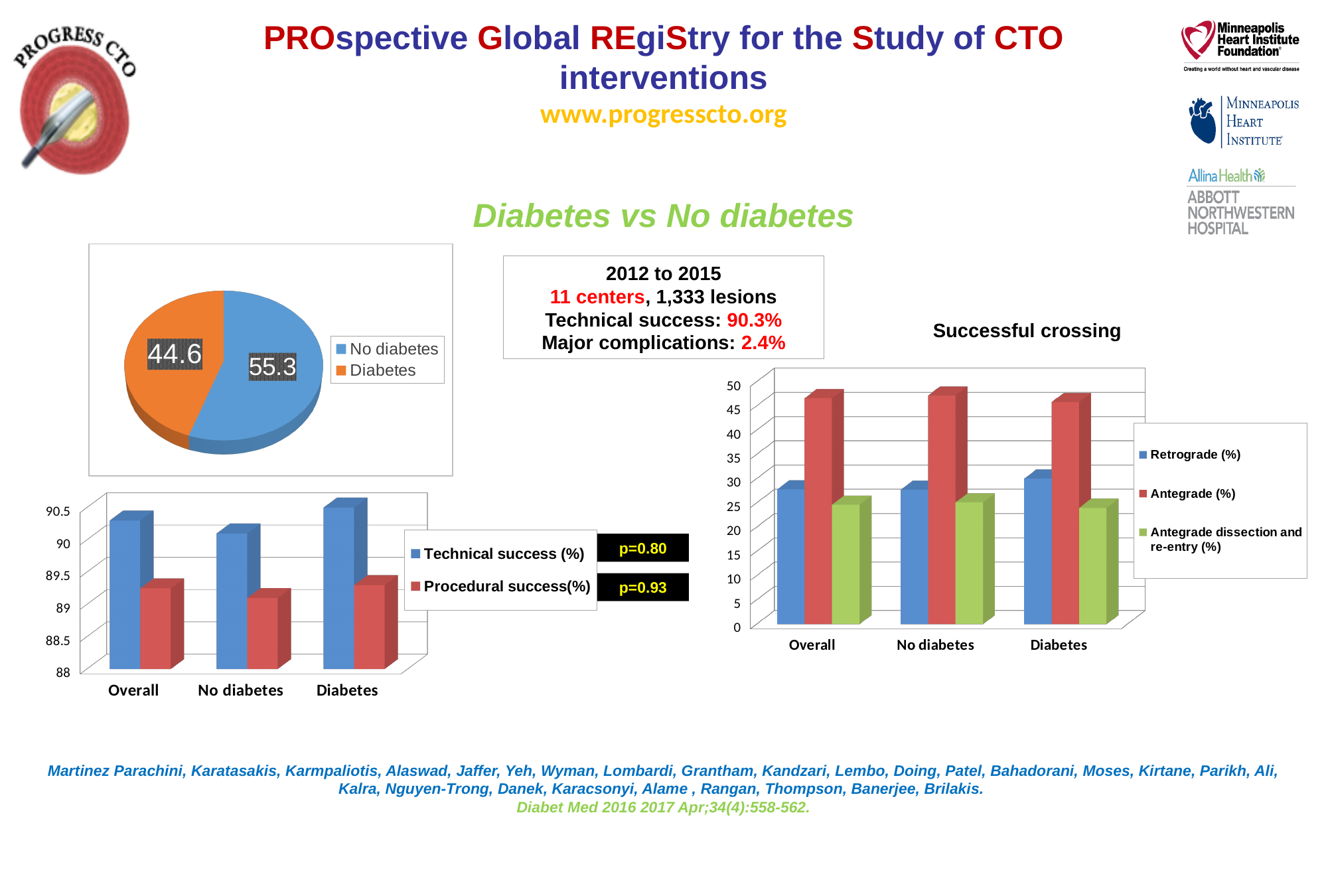
In the Successful crossing chart, is the Antegrade (%) value for Overall greater or less than 40? greater In the bottom-left bar chart, how many categories are shown on the x axis? 3 In the pie chart, what is the value for No diabetes? 55.3 In the pie chart, what is the value for Diabetes? 44.6 In the pie chart, which slice is larger, No diabetes or Diabetes? No diabetes In the Successful crossing chart, how many series does the legend list? 3 What kind of chart is the chart at the top left of the slide? Pie chart In the bottom-left bar chart, is the Technical success (%) value for Diabetes greater or less than 90? greater In the pie chart, what is the difference between the No diabetes and Diabetes values? 10.7 In the bottom-left bar chart, is the Procedural success(%) value for No diabetes greater or less than 89.5? less In the Successful crossing chart, which series has the highest value for Overall? Antegrade (%) In the bottom-left bar chart, how many series does the legend list? 2